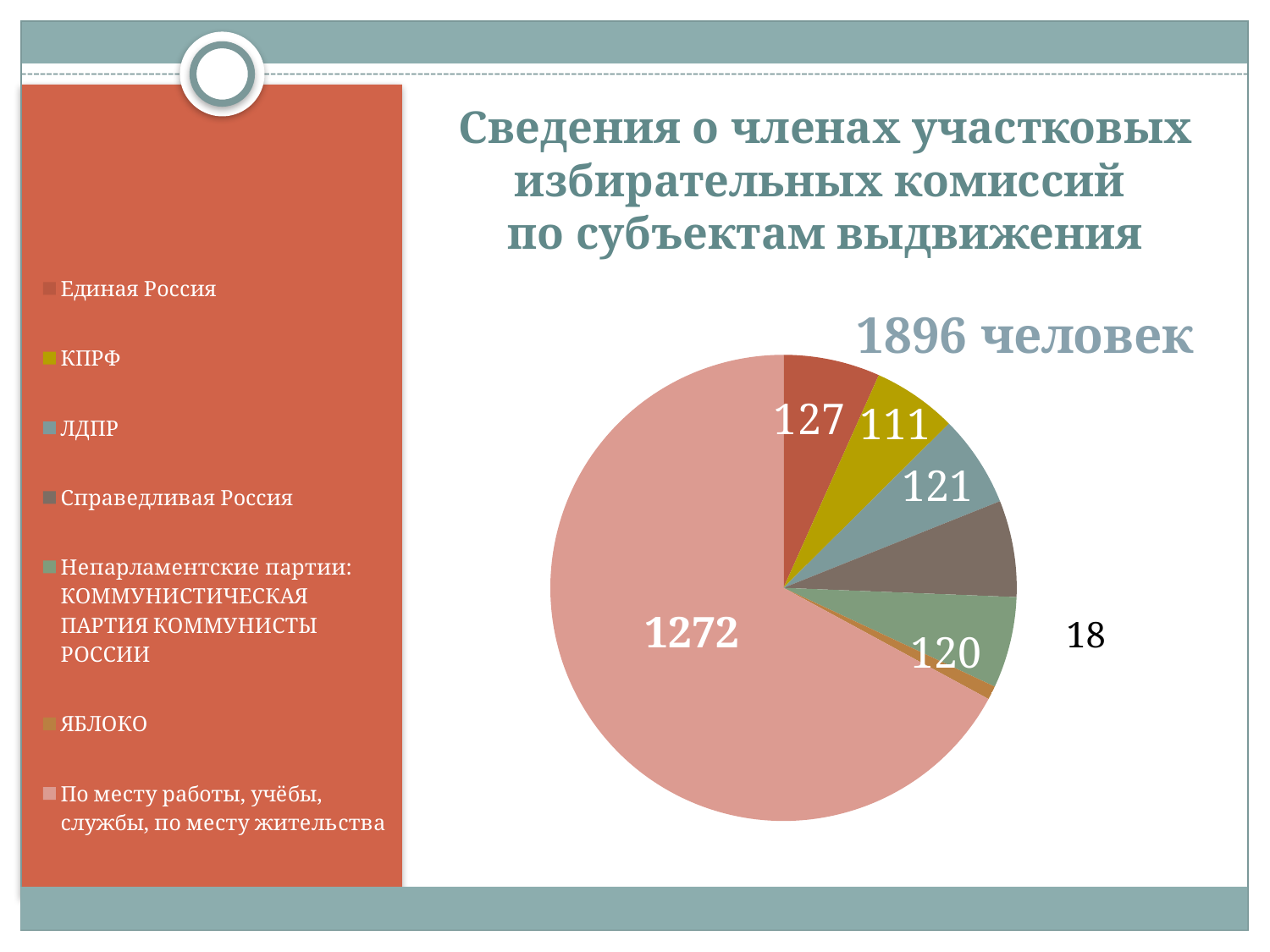
Which category has the largest slice of the pie chart? По месту работы, учёбы, службы, по месту жительства What kind of chart is shown on the slide? pie chart How many categories does the legend of the pie chart list? 7 What value is shown for the slice 'Непарламентские партии: КОММУНИСТИЧЕСКАЯ ПАРТИЯ КОММУНИСТЫ РОССИИ'? 120 Which is larger, the value for ЛДПР or the value for КПРФ? ЛДПР What value is shown for ЛДПР in the pie chart? 121 How many members were nominated by Единая Россия according to the pie chart? 127 What value is shown for КПРФ in the pie chart? 111 What value is shown for ЯБЛОКО in the pie chart? 18 Which category has the smallest slice of the pie chart? ЯБЛОКО What value is shown for 'По месту работы, учёбы, службы, по месту жительства'? 1272 What is the difference between the values for Единая Россия and КПРФ? 16